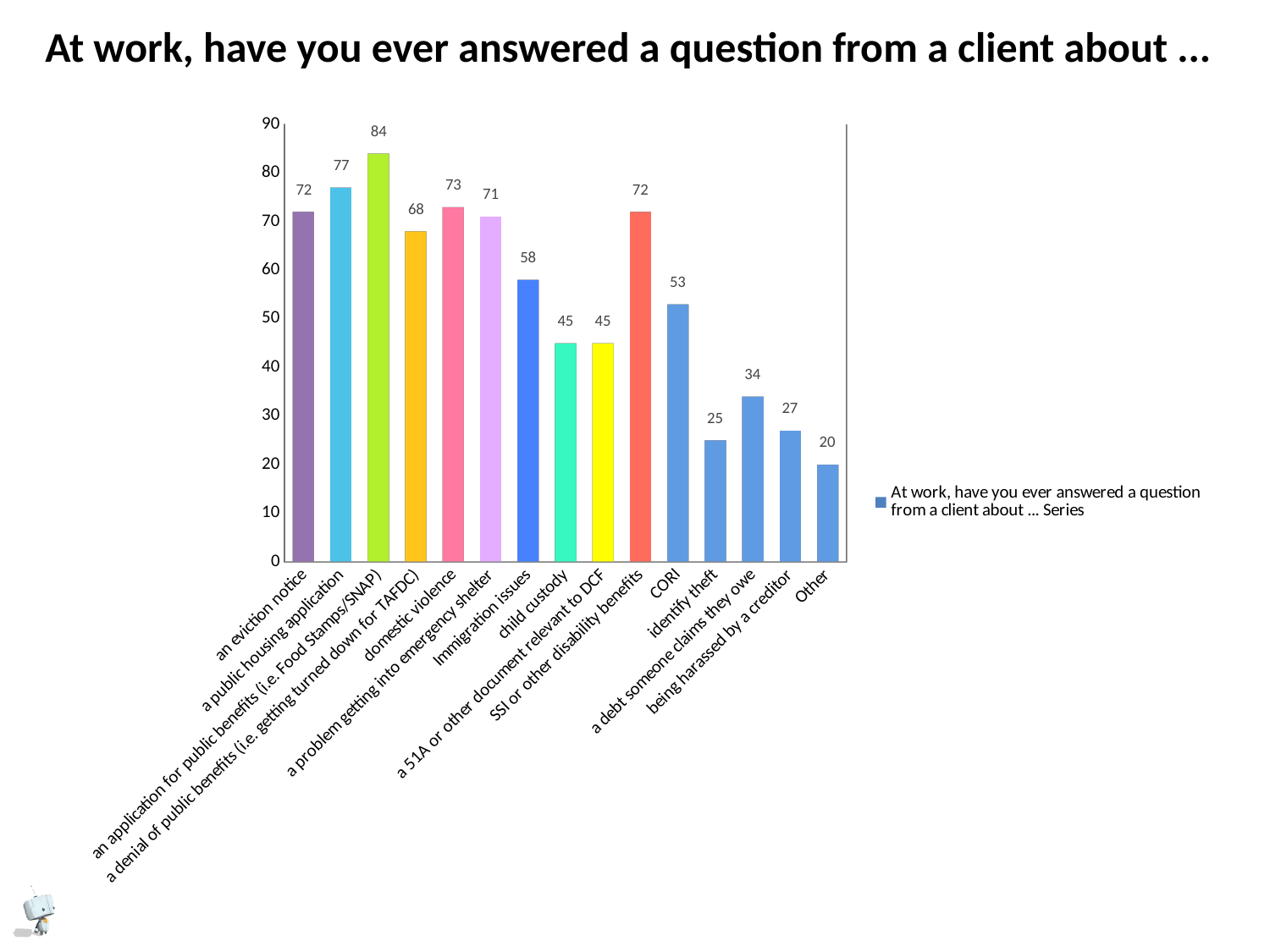
What is the value for 'a debt someone claims they owe'? 34 How many categories are shown on the x axis? 15 What is the difference between the values for 'a public housing application' and 'identify theft'? 52 What is the value for 'domestic violence'? 73 Which is larger, the value for 'Immigration issues' or the value for 'child custody'? Immigration issues Which category has the highest value? an application for public benefits (i.e. Food Stamps/SNAP) Which category has the lowest value? Other Is the value for 'being harassed by a creditor' greater or less than 30? less What is the value for 'CORI'? 53 What kind of chart is shown on the slide? bar chart What is the title of the slide? At work, have you ever answered a question from a client about ... How many series does the legend list? 1